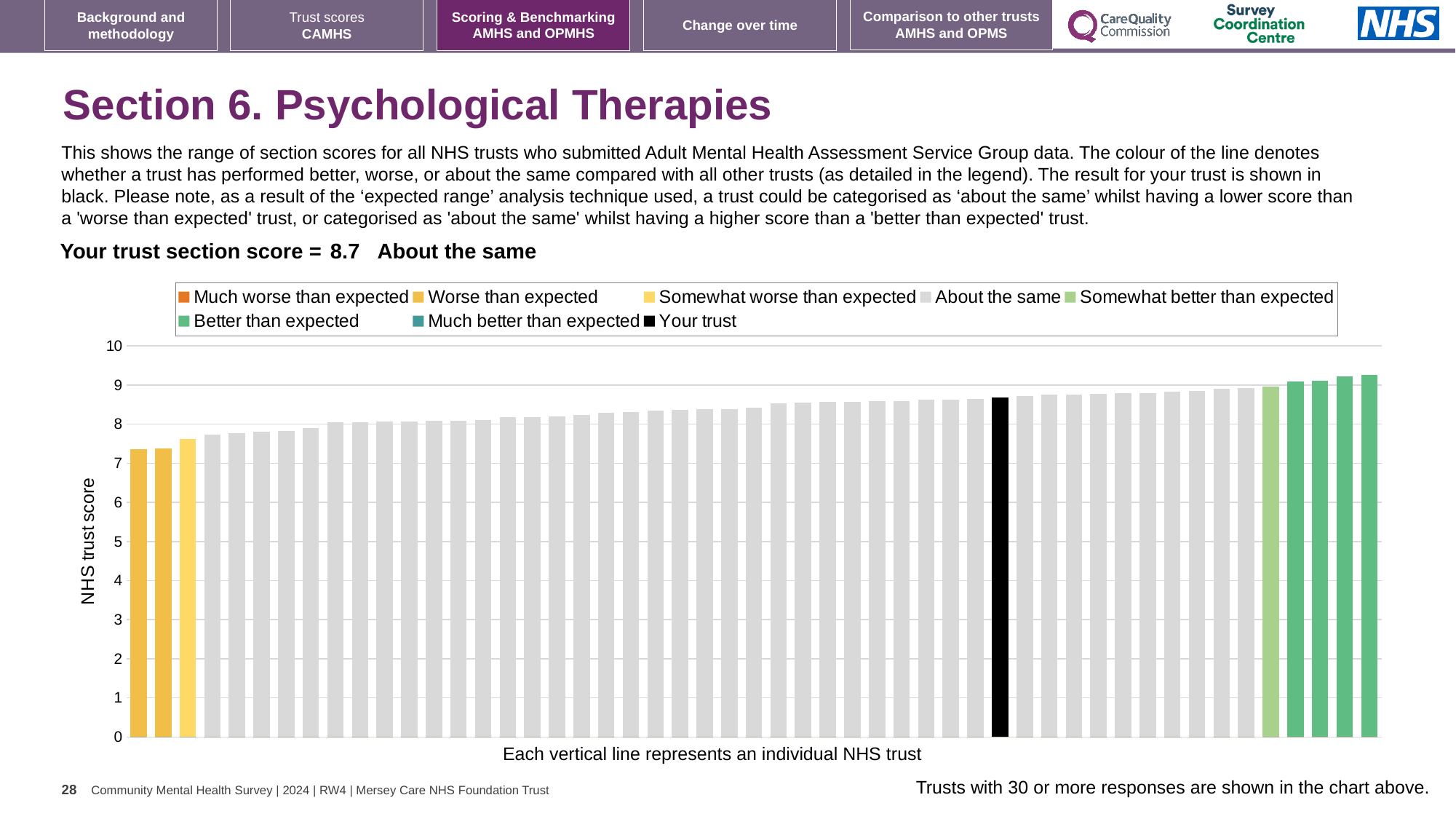
Do the bar values rise or fall from left to right along the x axis? rise Is the value of the tallest bar in the chart greater or less than 9? greater Which category is your trust's section score placed in? About the same What colour is the bar representing your trust? black Is the value of the black 'Your trust' bar greater or less than 9? less How many bars are coloured as 'Better than expected' (dark green)? 4 What is the label of the y axis? NHS trust score Is the value of the black 'Your trust' bar greater or less than 8? greater What kind of chart is shown on the slide? bar chart What is your trust's section score shown on the slide? 8.7 How many entries does the chart legend list? 8